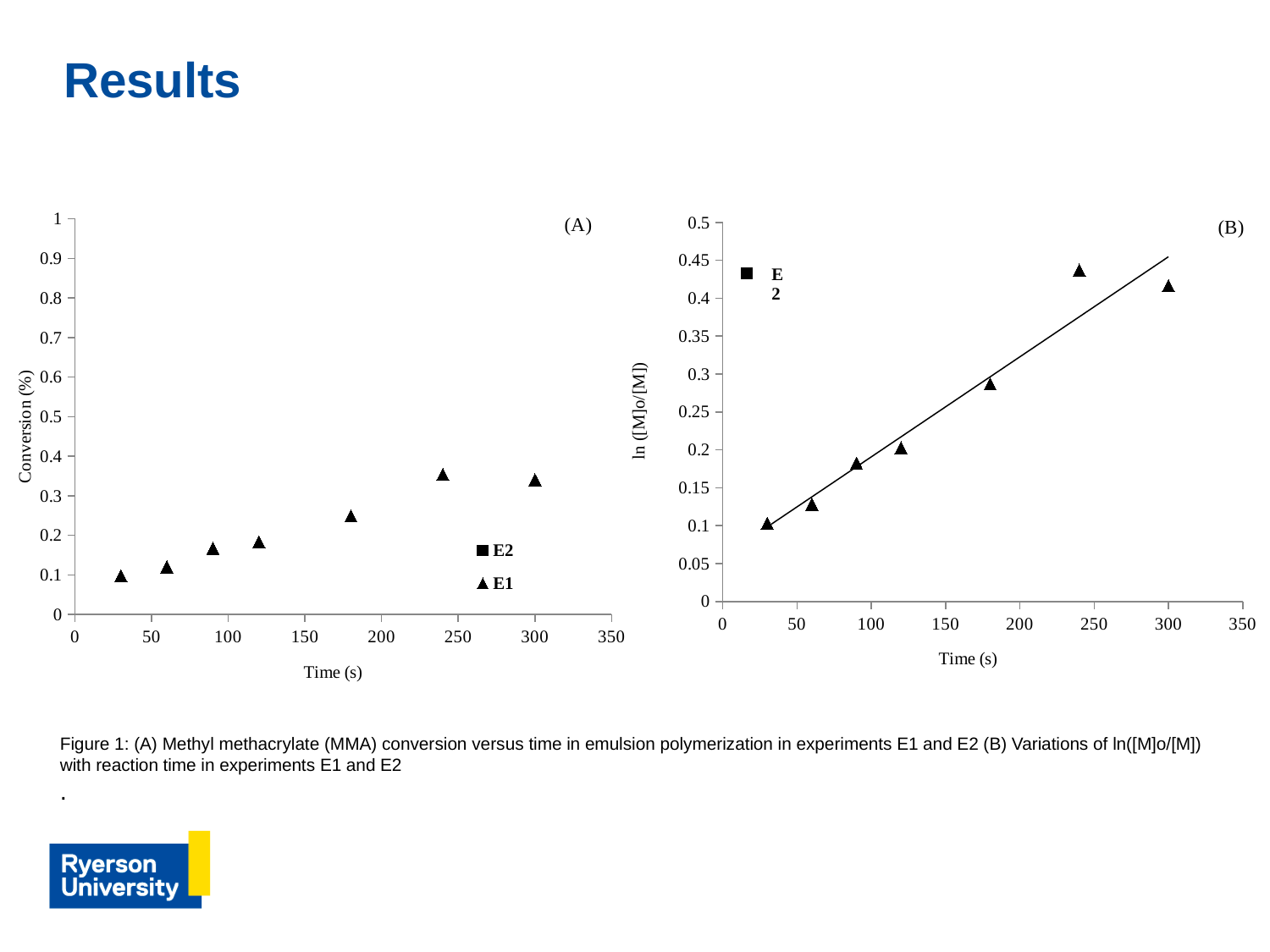
In chart (B), do the plotted values generally rise or fall as time increases? rise In chart (B), which is larger, the value at 300 s or the value at 120 s? 300 s How many series does the legend of chart (A) list? 2 In chart (B), is the ln([M]o/[M]) value at 90 s greater or less than 0.2? less What kind of chart is chart (A)? scatter chart How many data points are plotted in chart (A)? 7 How many data points are plotted in chart (B)? 7 What is the y-axis label of chart (A)? Conversion (%) In chart (A), which time has the lowest conversion value? 30 s In chart (A), is the conversion value at 180 s greater or less than 0.2? greater In chart (B), is the ln([M]o/[M]) value at 240 s greater or less than 0.4? greater